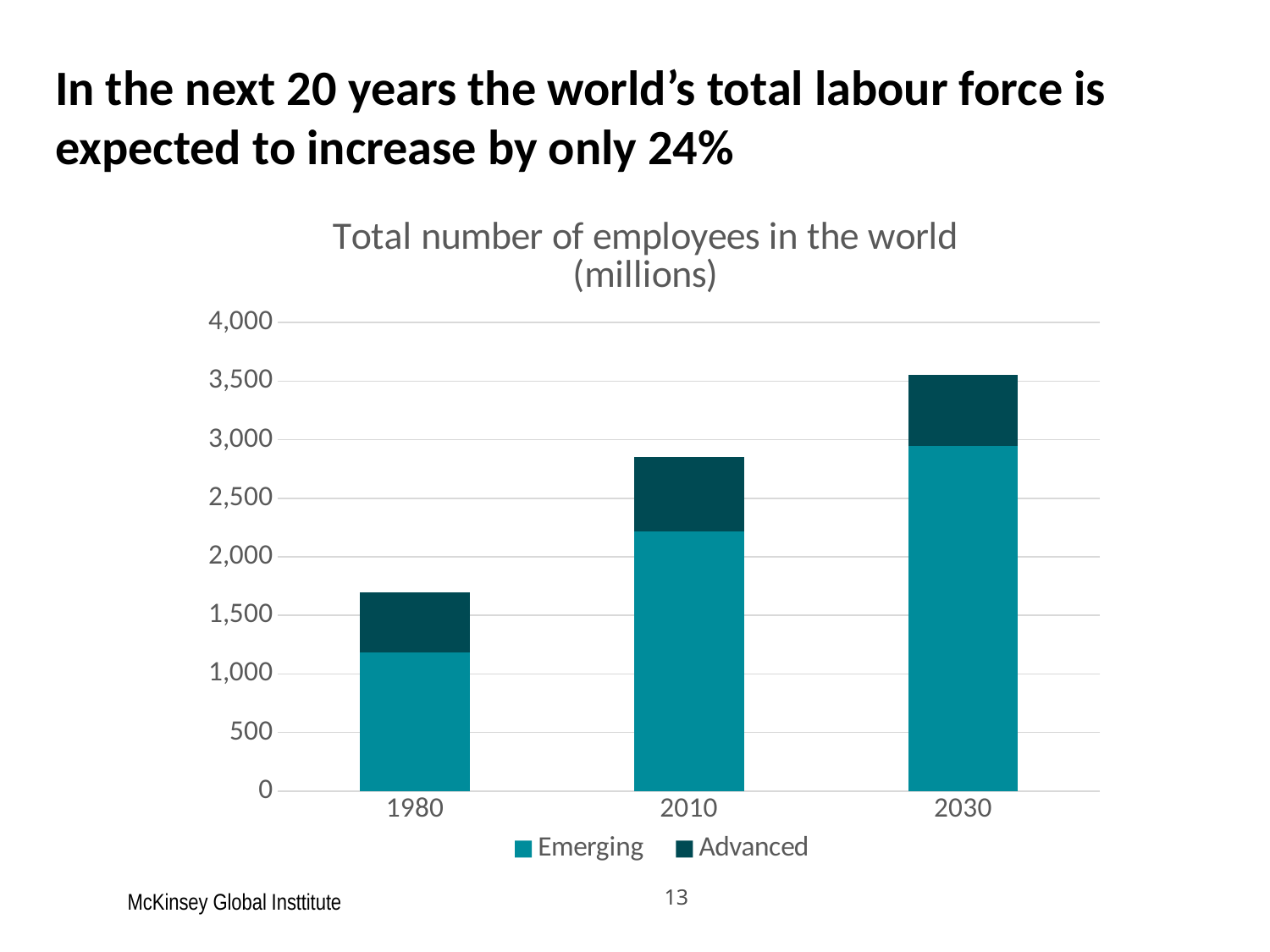
Which year has the highest total number of employees? 2030 What kind of chart is shown on the slide? Stacked bar chart Which year has the lowest total number of employees? 1980 Is the total bar for 1980 greater or less than 2,000? less How many series does the legend list? 2 Is the Emerging value for 2010 greater or less than 2,000? greater Is the total bar for 2030 greater or less than 3,000? greater What is the title of the chart? Total number of employees in the world (millions) In 2030, which segment is larger, Emerging or Advanced? Emerging Do the total bar heights rise or fall from 1980 to 2030? Rise Which series are listed in the legend? Emerging and Advanced How many years are shown on the x axis? 3